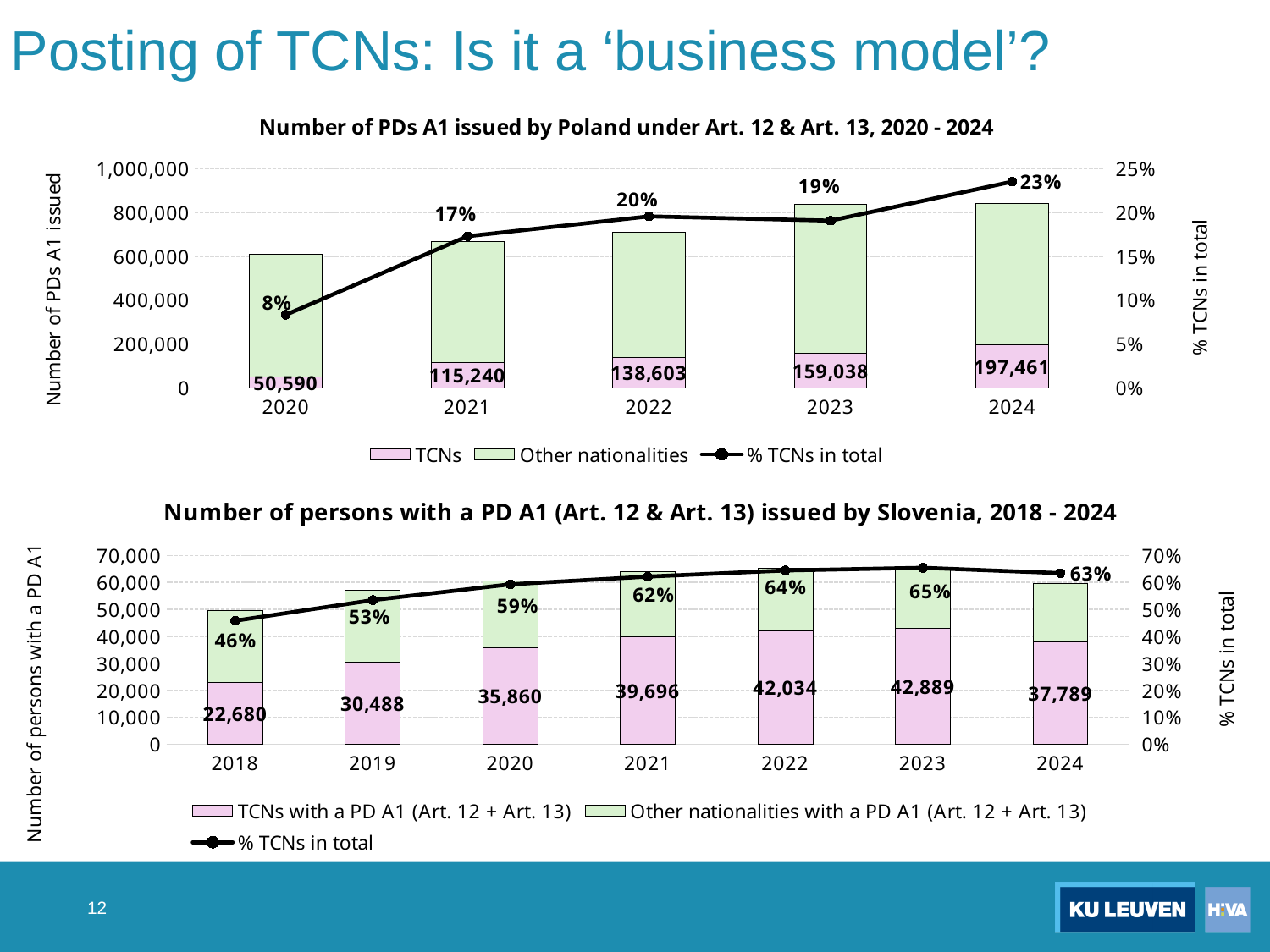
In the Slovenia chart, does the % TCNs in total rise or fall from 2018 to 2023? rise In the Poland chart, how many TCNs were issued PDs A1 in 2024? 197,461 In the Slovenia chart, how many TCNs with a PD A1 were there in 2019? 30,488 In the Poland chart, what was the % TCNs in total in 2021? 17% In the Slovenia chart, is the TCN value for 2022 larger or smaller than the TCN value for 2024? larger In the Poland chart, which year has the lowest number of TCNs? 2020 In the Poland chart, how many series does the legend list? 3 In the Poland chart, what is the difference between the TCN values for 2024 and 2023? 38,423 In the Slovenia chart, which year has the highest % TCNs in total? 2023 In the Poland chart, is the total number of PDs A1 issued in 2020 greater or less than 800,000? less In the Slovenia chart, how many years are shown on the x axis? 7 What kind of chart is the Slovenia chart? Stacked bar chart with a line